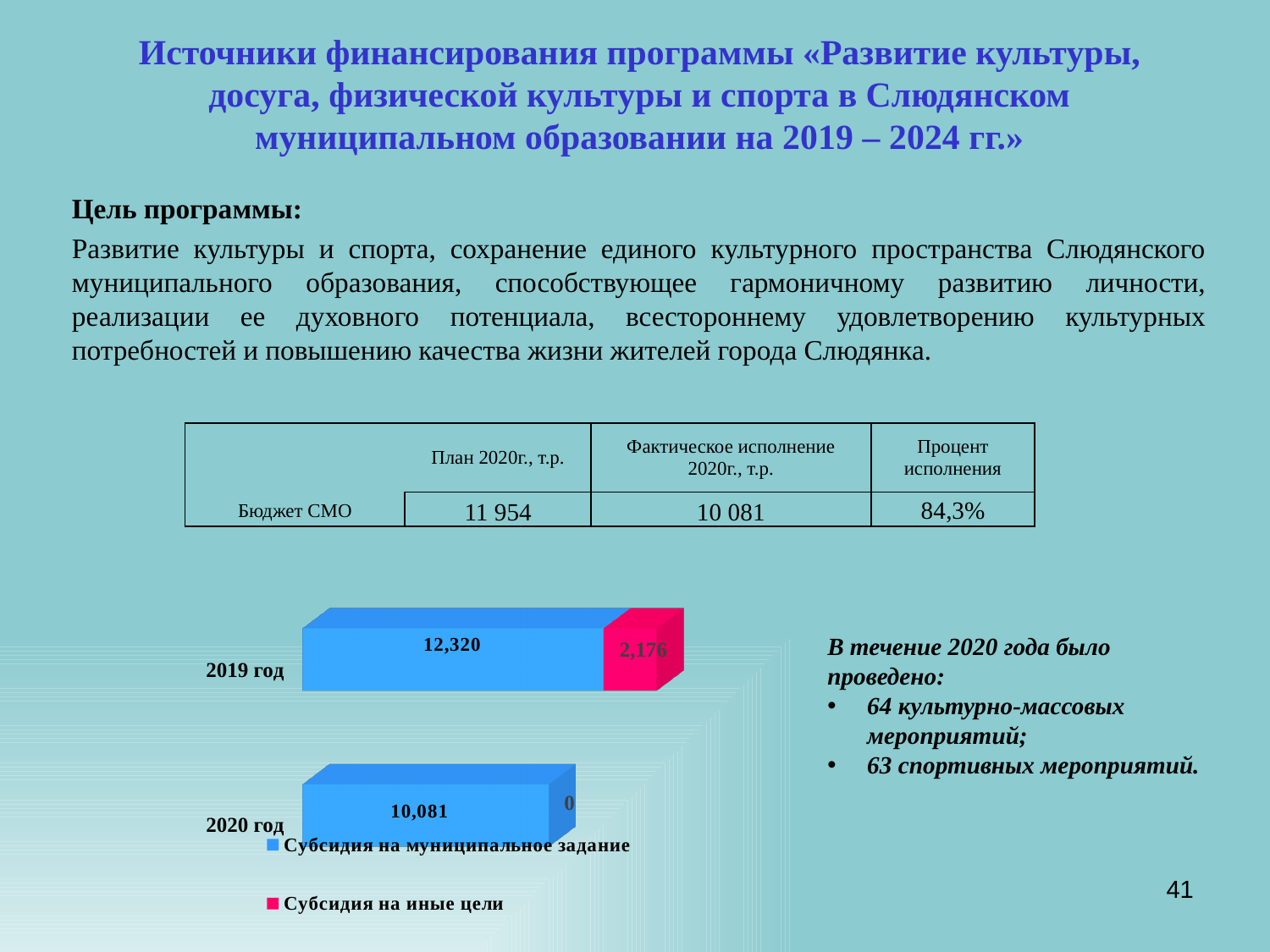
What is the total of the stacked bar for 2020 год? 10,081 What is the value of 'Субсидия на иные цели' for 2020 год? 0 What kind of chart is shown on the slide? bar chart What is the difference between the 'Субсидия на муниципальное задание' values for 2019 год and 2020 год? 2,239 What is the total of the stacked bar for 2019 год? 14,496 What is the value of 'Субсидия на муниципальное задание' for 2020 год? 10,081 Which colour represents 'Субсидия на иные цели' in the chart? pink How many categories (years) are shown on the chart? 2 What is the value of 'Субсидия на муниципальное задание' for 2019 год? 12,320 What is the value of 'Субсидия на иные цели' for 2019 год? 2,176 How many series does the chart legend list? 2 Which year has the larger value for 'Субсидия на муниципальное задание', 2019 год or 2020 год? 2019 год